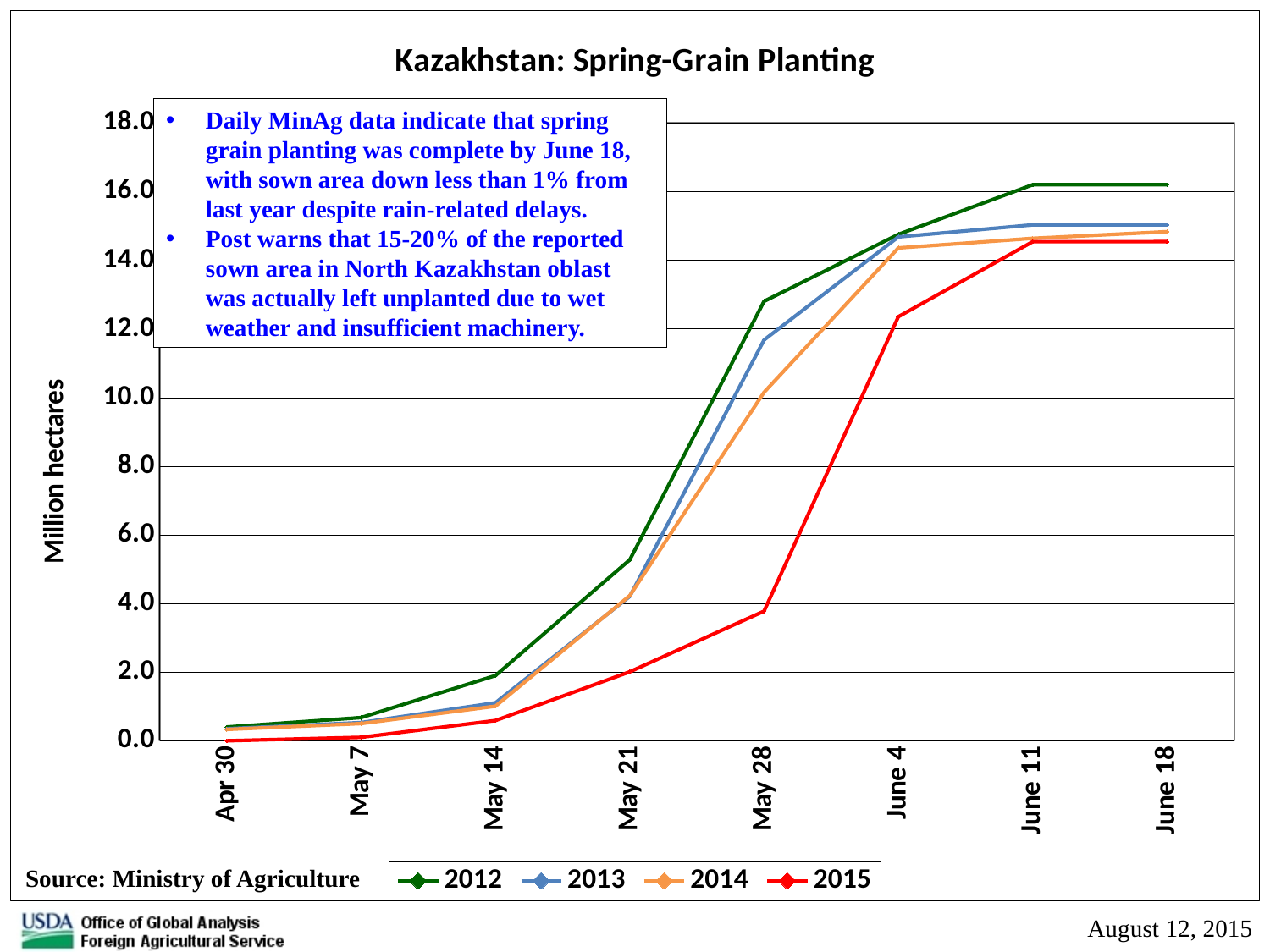
Is the value for 2012 on May 21 greater or less than 6.0? less What is the label on the y axis? Million hectares Which is larger on May 28, the value for 2012 or the value for 2015? 2012 Is the value for 2013 on June 18 greater or less than 16.0? less Which year has the highest planted area on June 18? 2012 What kind of chart is shown on the slide? line chart Which year has the lowest planted area on June 18? 2015 How many dates are shown along the x axis? 8 Is the value for 2012 on May 28 greater or less than 12.0? greater How many series does the legend list? 4 Do the values for 2015 rise or fall from Apr 30 to June 18? rise